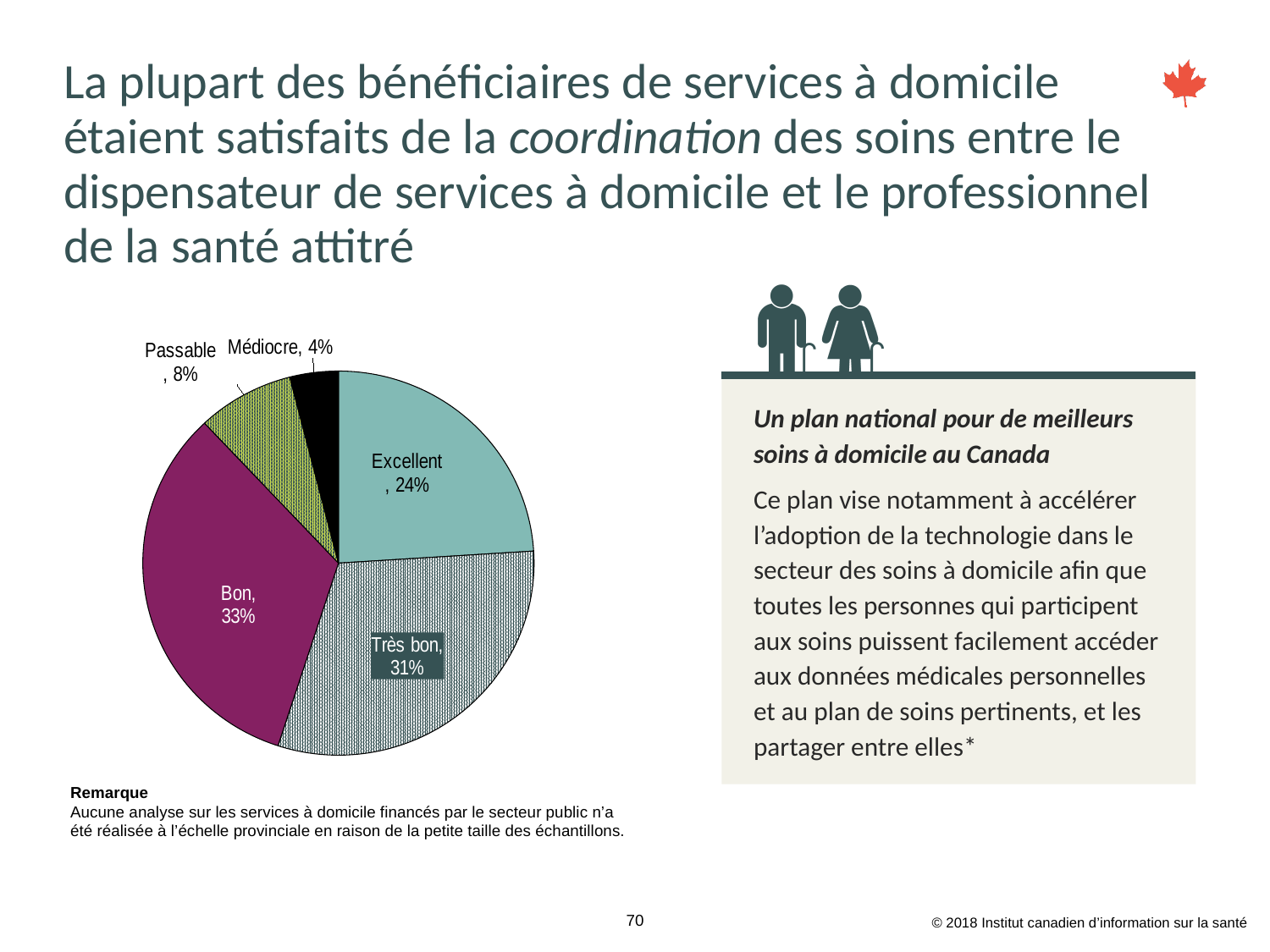
Which slice of the pie chart is the largest? Bon What is the difference in percentage points between the "Bon" slice and the "Excellent" slice? 9 What percentage of the pie chart is labelled "Passable"? 8% What is the combined share of the "Excellent" and "Très bon" slices? 55% Which slice is larger, "Passable" or "Médiocre"? Passable What percentage of the pie chart is labelled "Excellent"? 24% What percentage of the pie chart is labelled "Bon"? 33% What percentage of the pie chart is labelled "Très bon"? 31% How many slices does the pie chart have? 5 What kind of chart is shown on the slide? pie chart Which slice of the pie chart is the smallest? Médiocre What percentage of the pie chart is labelled "Médiocre"? 4%